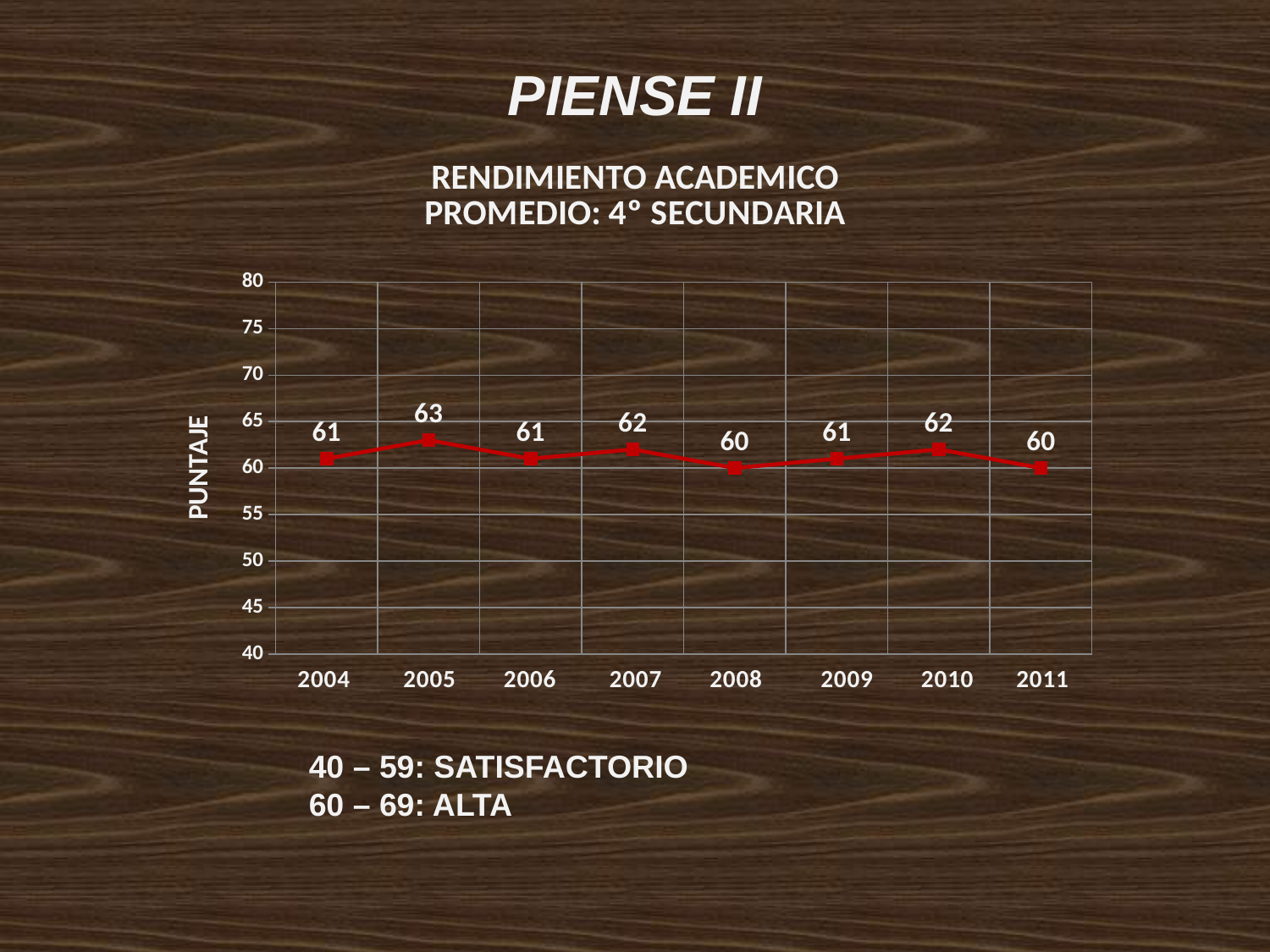
Does the value rise or fall from 2010 to 2011? fall What kind of chart is shown? line chart What is the title of the chart? RENDIMIENTO ACADEMICO PROMEDIO: 4° SECUNDARIA What is the value for 2011? 60 How many years are plotted on the x axis? 8 Which year has the highest value? 2005 What is the value for 2005? 63 Which is larger, the value for 2007 or the value for 2006? 2007 What is the label of the vertical axis? PUNTAJE What is the difference between the values for 2005 and 2008? 3 Is the value for 2010 greater or less than 70? less What is the value for 2008? 60